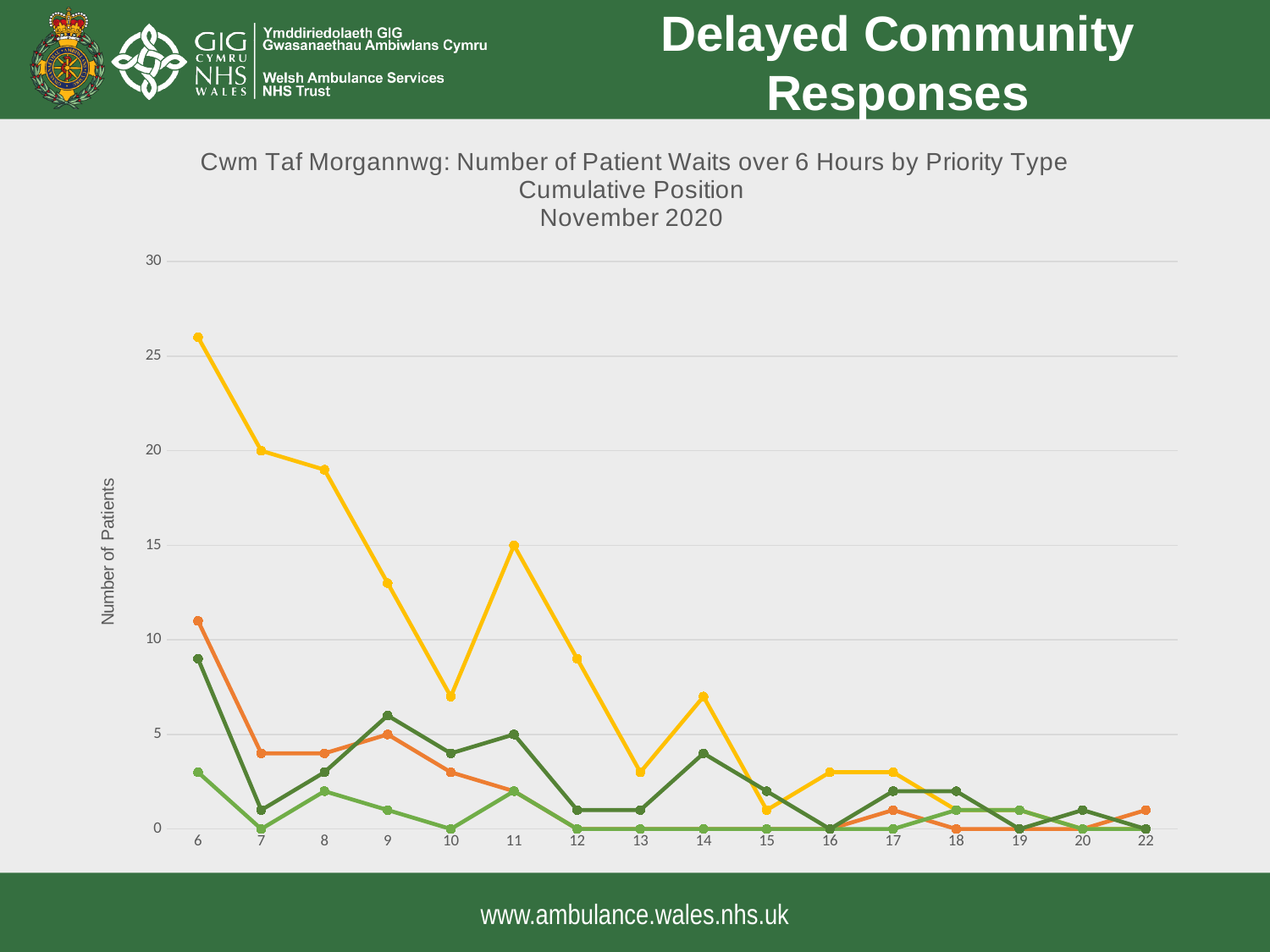
Does the yellow line generally rise or fall from x = 6 to x = 22? fall What is the value of the yellow line at x = 7? 20 What is the title of the chart? Cwm Taf Morgannwg: Number of Patient Waits over 6 Hours by Priority Type Cumulative Position November 2020 What kind of chart is shown on the slide? line chart Which line has the highest value at x = 6? the yellow line At which x-axis value does the yellow line reach its highest point? 6 Is the value of the orange line at x = 6 greater or less than 10? greater What is the value of the yellow line at x = 11? 15 How many points are labelled along the x axis? 16 Is the value of the yellow line at x = 10 greater or less than 10? less Is the value of the yellow line at x = 6 greater or less than 25? greater